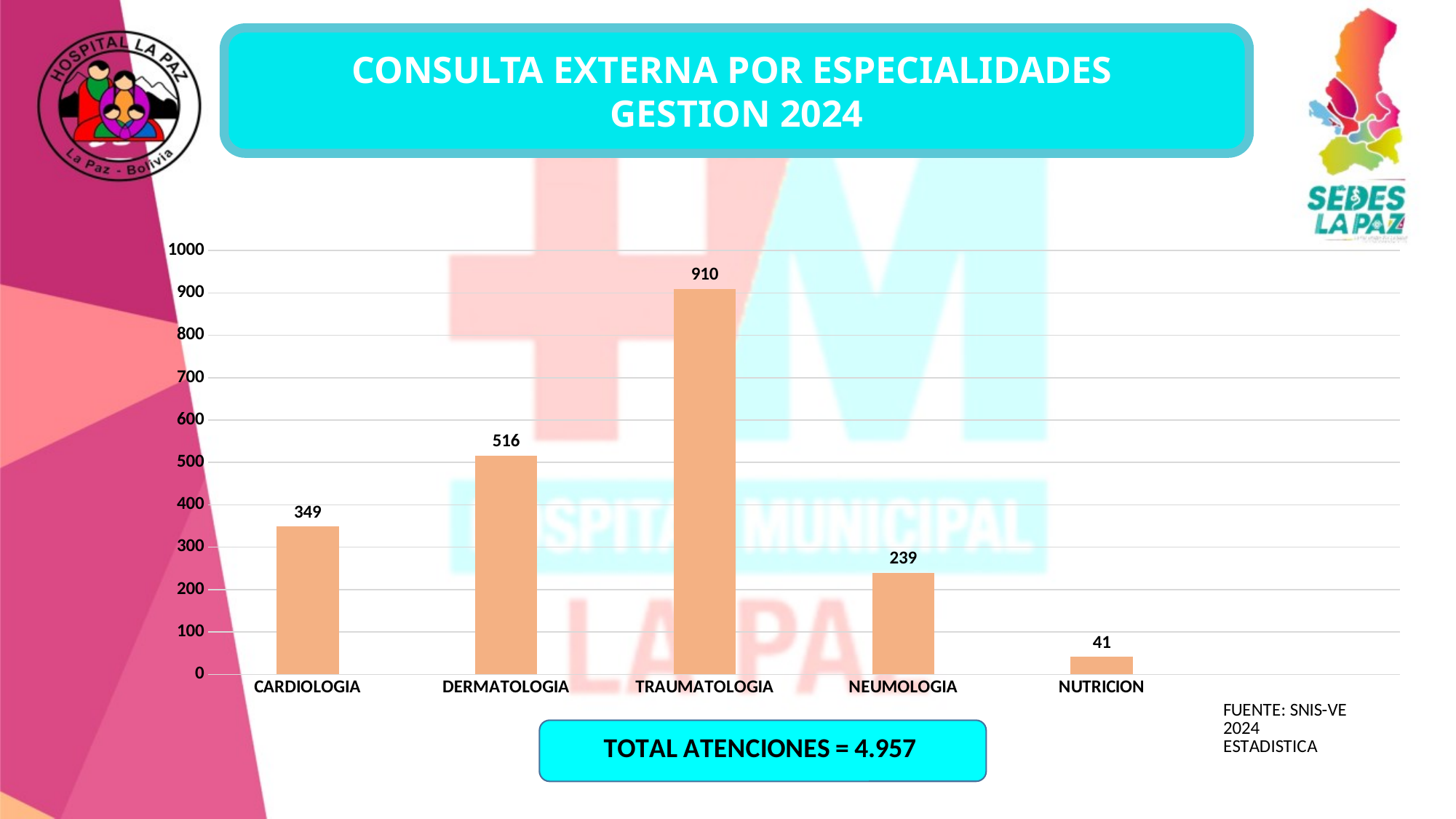
Is the value for NEUMOLOGIA greater or less than 300? less Which specialty has the highest value? TRAUMATOLOGIA Which is larger, the value for CARDIOLOGIA or the value for DERMATOLOGIA? DERMATOLOGIA What is the value for TRAUMATOLOGIA? 910 How many specialties are shown on the x axis? 5 What total number of attentions is stated below the chart? 4.957 What is the value for CARDIOLOGIA? 349 What is the value for NUTRICION? 41 What kind of chart is shown on the slide? bar chart What is the title of the slide's chart? CONSULTA EXTERNA POR ESPECIALIDADES GESTION 2024 Which specialty has the lowest value? NUTRICION What is the difference between the values for DERMATOLOGIA and NEUMOLOGIA? 277